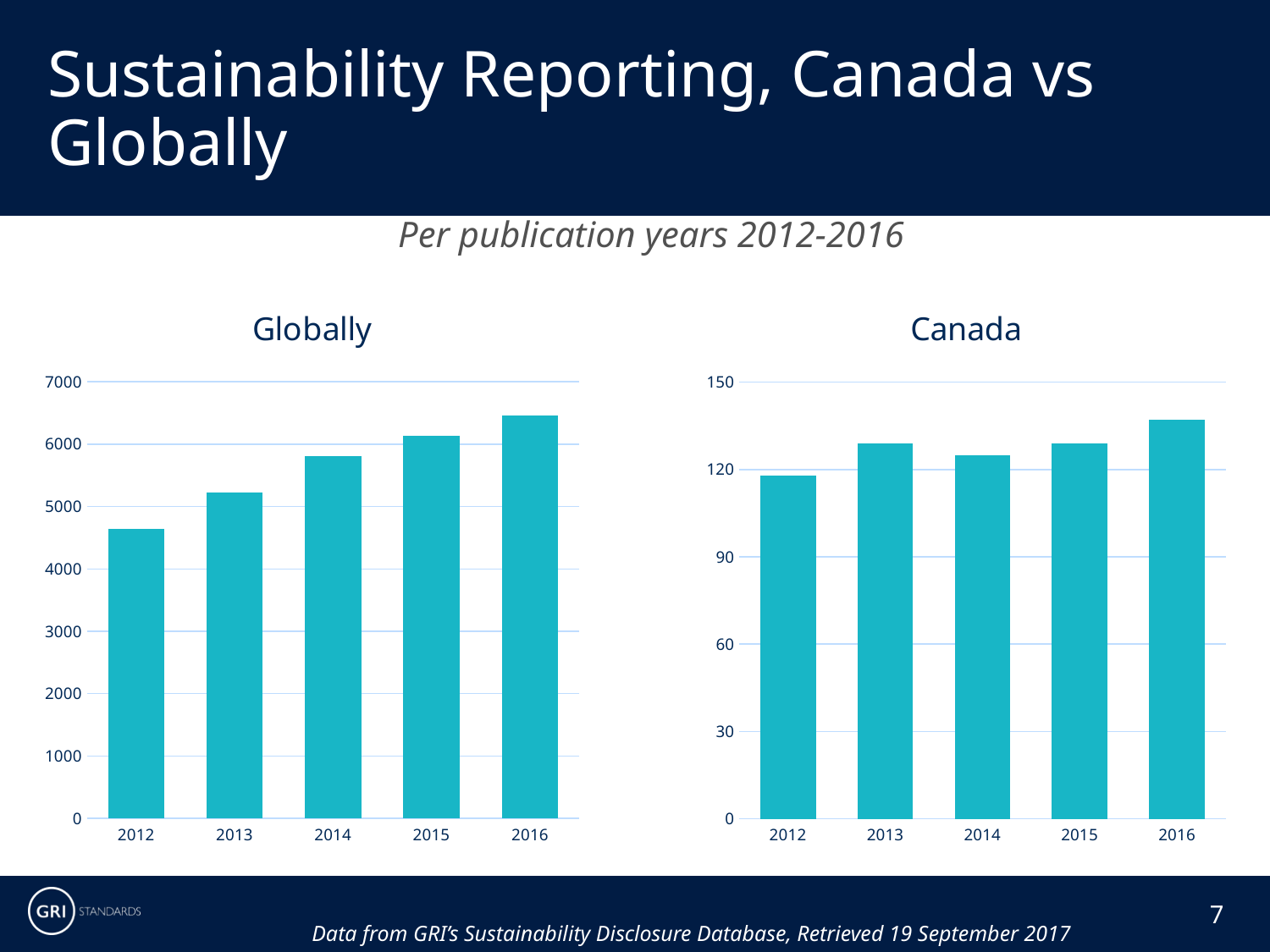
In the Globally chart, which year has the lowest value? 2012 In the Canada chart, which year has the larger value, 2012 or 2014? 2014 What kind of chart is the Globally chart? bar chart In the Globally chart, is the value for 2016 greater or less than 6000? greater How many years are shown on the x axis of the Canada chart? 5 In the Globally chart, do the values rise or fall from 2012 to 2016? rise In the Canada chart, which year has the highest value? 2016 In the Canada chart, is the value for 2016 greater or less than 120? greater In the Canada chart, which year has the lowest value? 2012 In the Globally chart, is the value for 2012 greater or less than 5000? less In the Globally chart, which year has the highest value? 2016